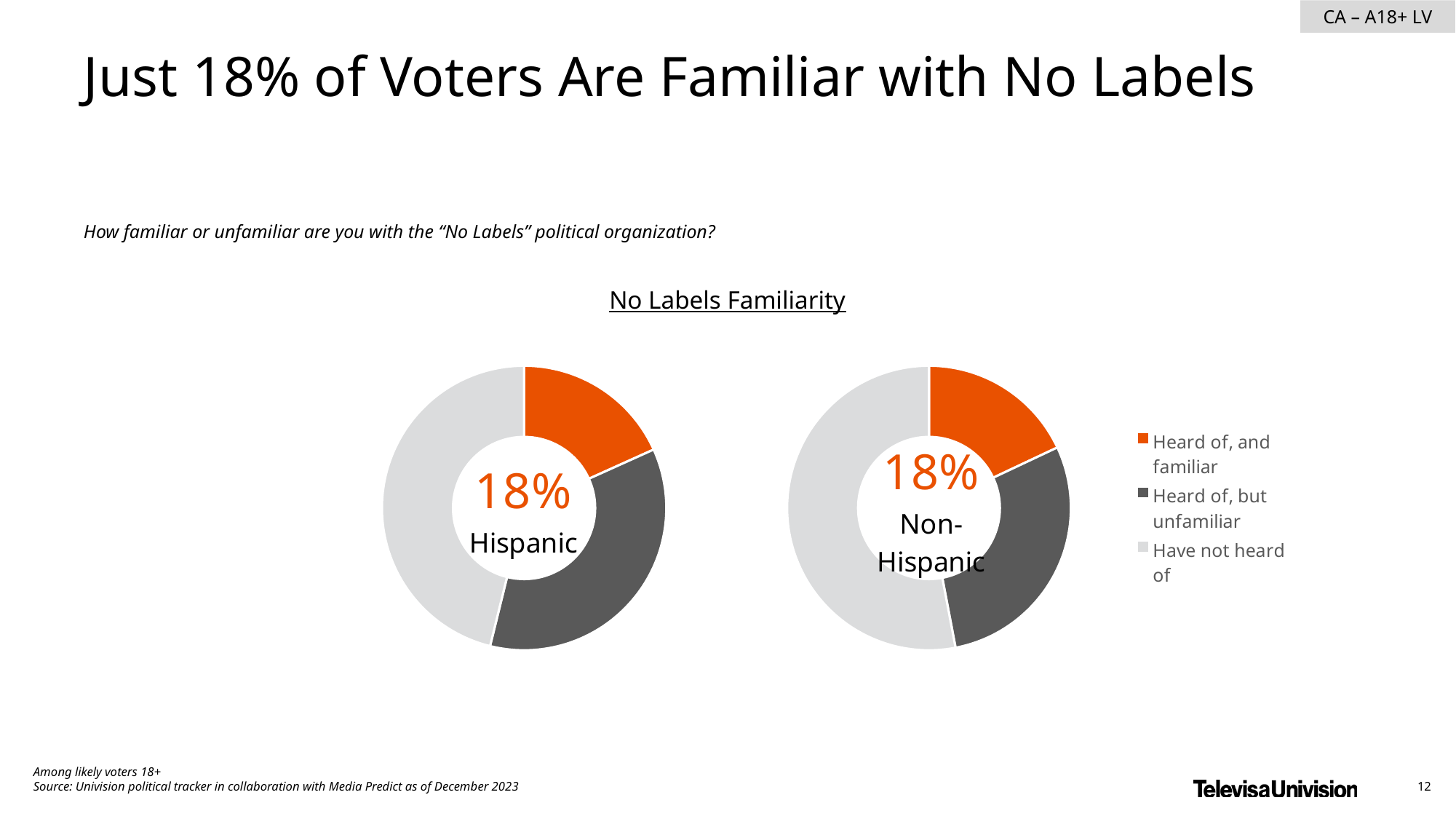
How many categories does the legend list for the No Labels Familiarity charts? 3 What kind of chart is used to show No Labels familiarity for Hispanic and Non-Hispanic voters? Pie (donut) chart In the Non-Hispanic chart, which category is the smallest slice? Heard of, and familiar In the Hispanic chart, what percentage of respondents have heard of and are familiar with No Labels? 18% In the Hispanic chart, is the 'Have not heard of' share greater or less than 25%? greater Is the 'Heard of, and familiar' share for Hispanic voters greater or less than 18%, compared with Non-Hispanic voters? They are equal, both 18% How many slices does the Hispanic donut chart have? 3 In the Non-Hispanic chart, what percentage of respondents have heard of and are familiar with No Labels? 18% Which colour represents 'Heard of, and familiar' in the charts? Orange In the Hispanic chart, which category is the smallest slice? Heard of, and familiar What is the title shown above the two donut charts? No Labels Familiarity